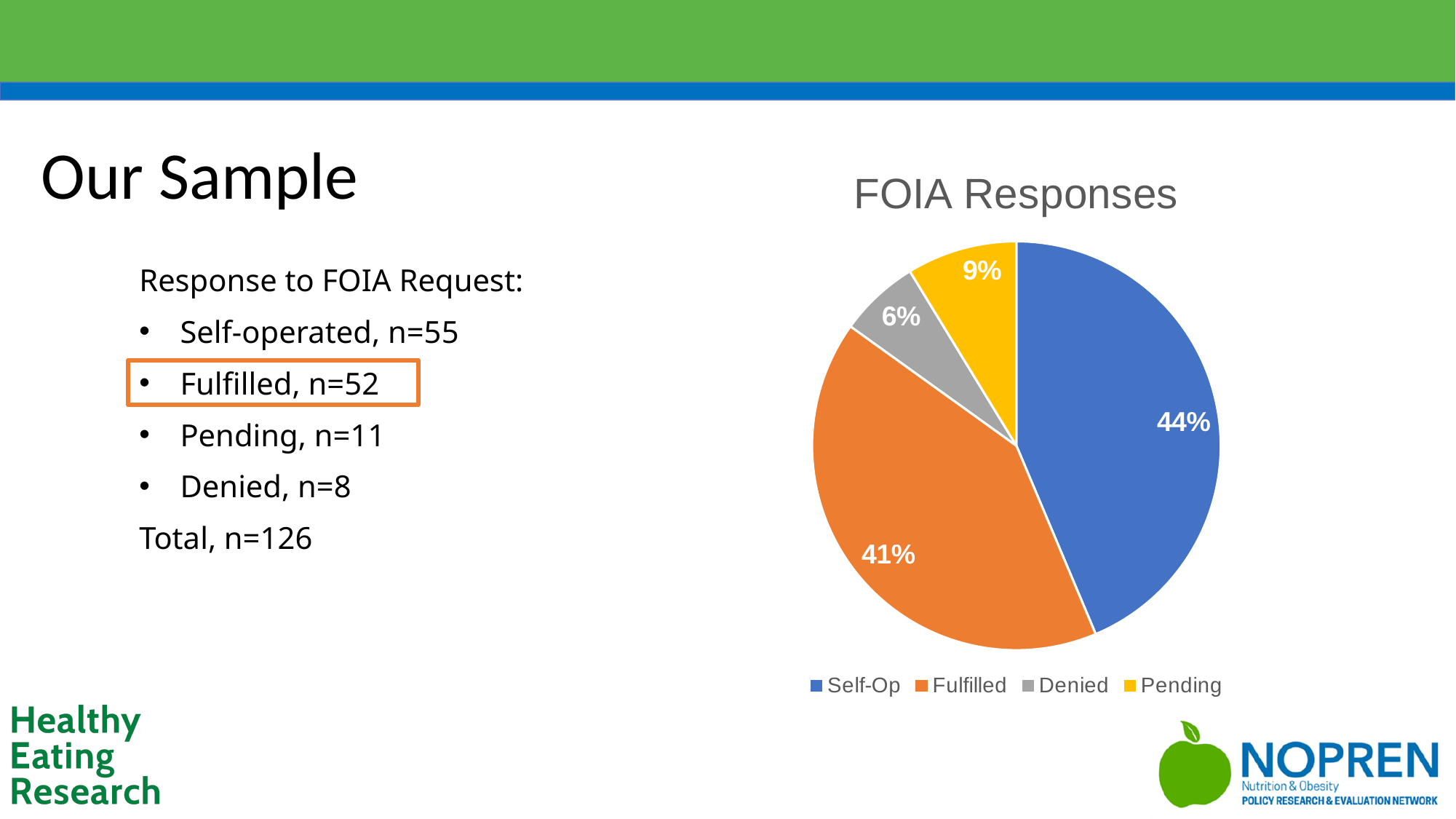
What percentage of the pie does the Self-Op slice represent? 44% What colour is the Fulfilled slice? orange How many categories does the legend list? 4 What type of chart is shown on the slide? pie chart Which category has the largest share of the pie? Self-Op What percentage of the pie does the Denied slice represent? 6% What percentage of the pie does the Fulfilled slice represent? 41% What is the title of the chart? FOIA Responses What is the difference in percentage points between the Self-Op and Fulfilled slices? 3 What percentage of the pie does the Pending slice represent? 9% Which slice is larger, Pending or Denied? Pending Which category has the smallest share of the pie? Denied